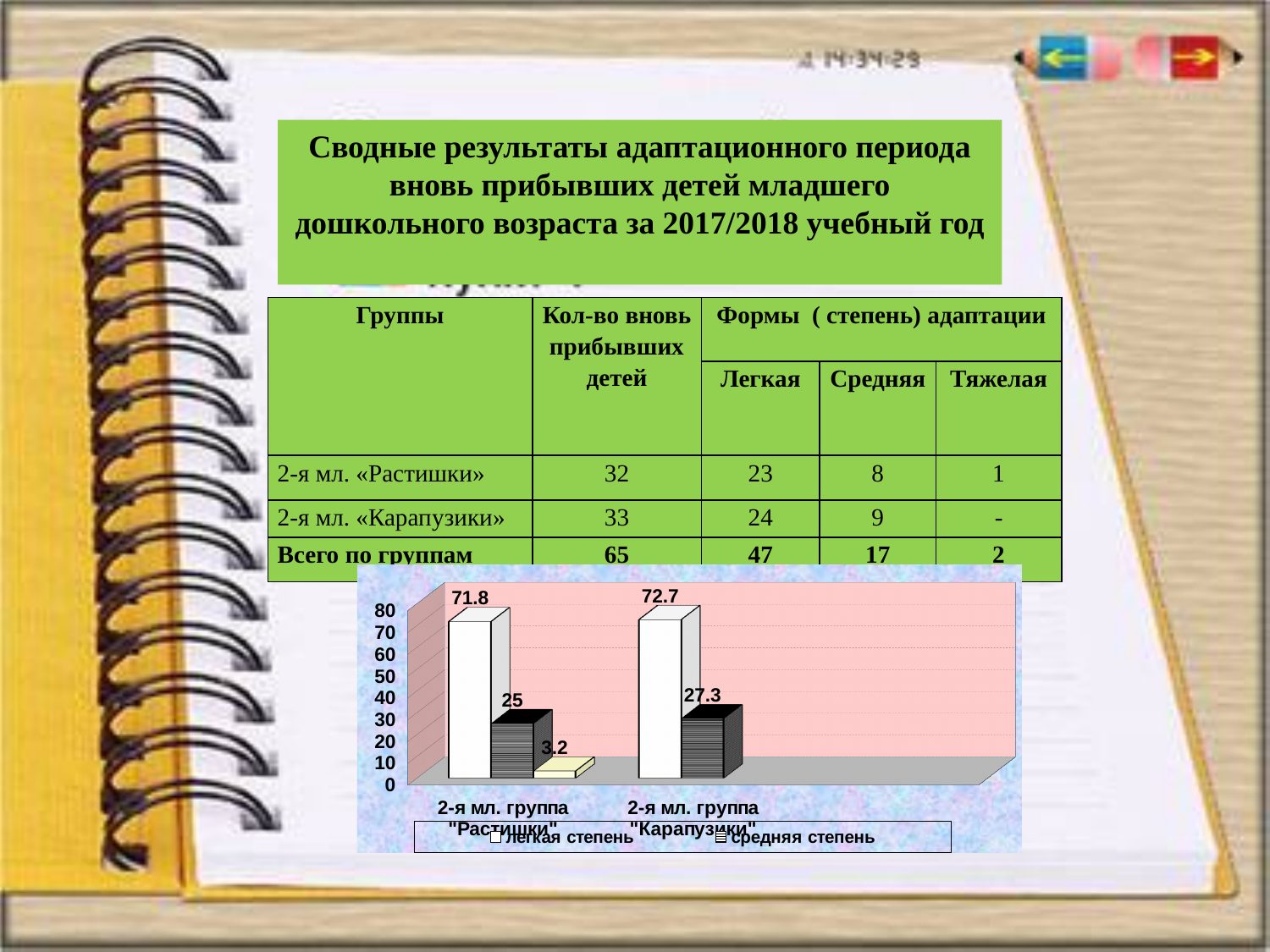
What is the difference between the Средняя степень values for "Карапузики" and "Растишки"? 2.3 What is the value of Средняя степень for 2-я мл. группа "Растишки"? 25 What colour are the Легкая степень bars in the chart? White Which group has the higher Легкая степень value, "Растишки" or "Карапузики"? 2-я мл. группа "Карапузики" What is the highest value labelled on the chart? 72.7 What kind of chart is shown on the slide? Bar chart What is the value of Легкая степень for 2-я мл. группа "Карапузики"? 72.7 How many groups (categories) are shown on the x axis of the chart? 2 What is the value of Легкая степень for 2-я мл. группа "Растишки"? 71.8 Is the Легкая степень value for "Растишки" greater or less than 50? greater What is the value of Средняя степень for 2-я мл. группа "Карапузики"? 27.3 For 2-я мл. группа "Растишки", how much larger is the Легкая степень value than the Средняя степень value? 46.8